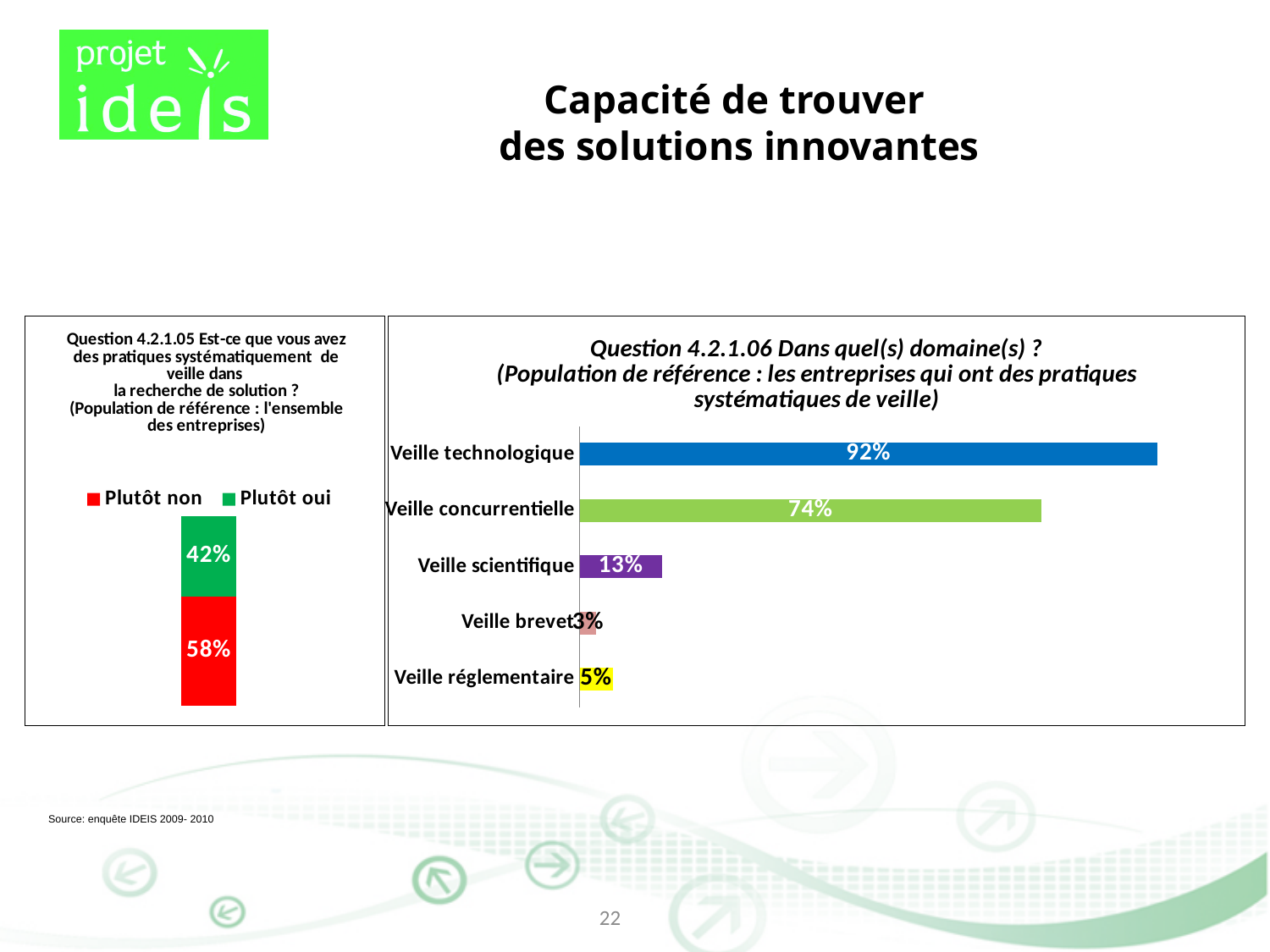
What kind of chart is the right-hand chart (Question 4.2.1.06)? Bar chart In the right-hand chart (Question 4.2.1.06), what is the value for Veille concurrentielle? 74% In the right-hand chart (Question 4.2.1.06), which category has the highest value? Veille technologique In the right-hand chart (Question 4.2.1.06), what is the value for Veille technologique? 92% In the right-hand chart (Question 4.2.1.06), what is the value for Veille scientifique? 13% How many categories are shown in the right-hand chart (Question 4.2.1.06)? 5 In the left-hand chart (Question 4.2.1.05), what is the value for Plutôt non? 58% In the right-hand chart (Question 4.2.1.06), which is larger, Veille réglementaire or Veille brevet? Veille réglementaire In the right-hand chart (Question 4.2.1.06), what is the difference between Veille technologique and Veille concurrentielle? 18% How many series does the legend of the left-hand chart (Question 4.2.1.05) list? 2 In the left-hand chart (Question 4.2.1.05), what is the value for Plutôt oui? 42% In the right-hand chart (Question 4.2.1.06), which category has the lowest value? Veille brevet